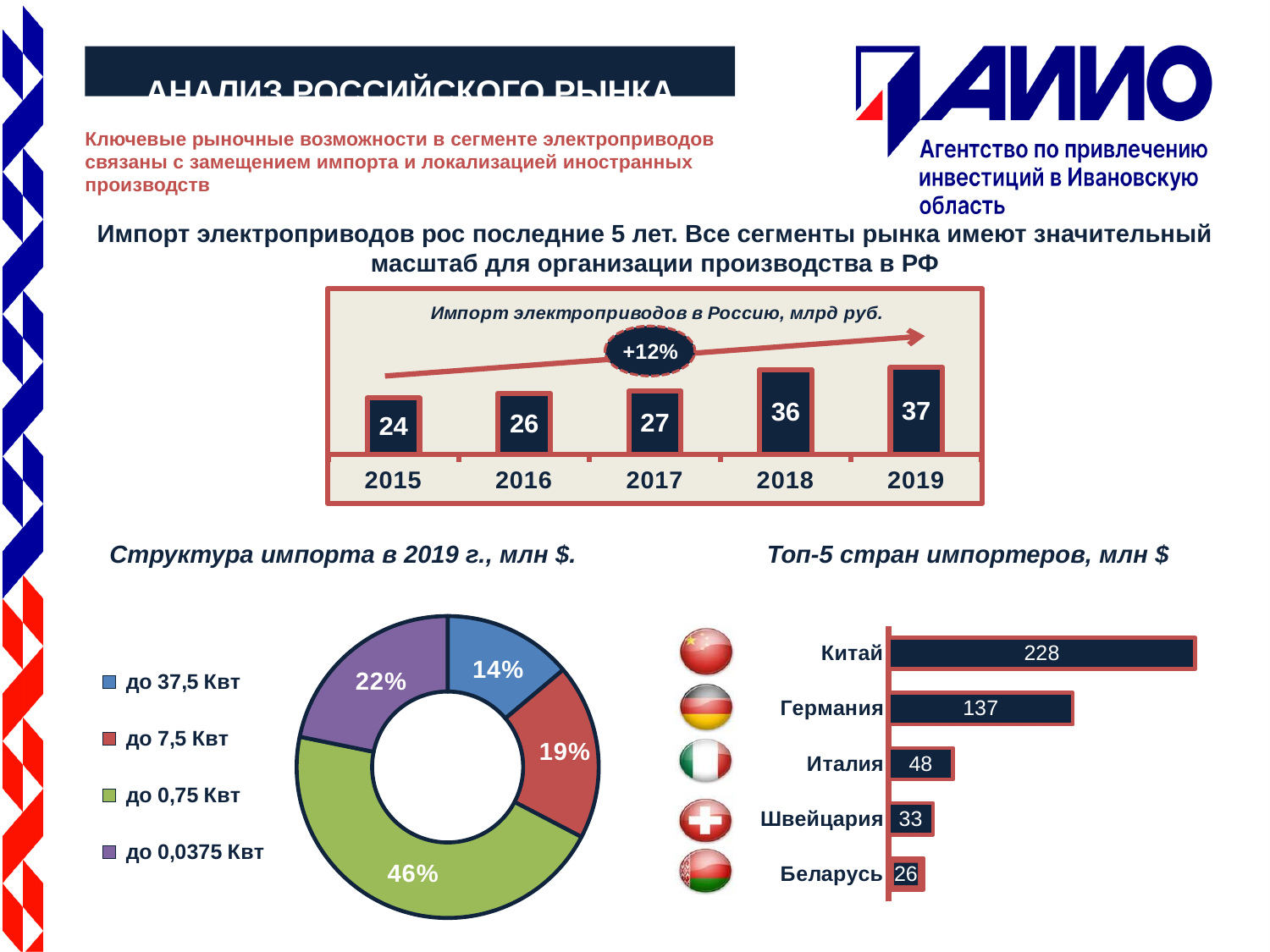
In the chart 'Структура импорта в 2019 г., млн $.', what share does 'до 0,75 Квт' have? 46% In the chart 'Топ-5 стран импортеров, млн $', what is the value for Германия? 137 In the chart 'Структура импорта в 2019 г., млн $.', which category has the smallest share? до 37,5 Квт In the chart 'Топ-5 стран импортеров, млн $', what is the difference between Китай and Италия? 180 In the chart 'Структура импорта в 2019 г., млн $.', what share does 'до 0,0375 Квт' have? 22% In the chart 'Импорт электроприводов в Россию, млрд руб.', what is the value for 2018? 36 In the chart 'Топ-5 стран импортеров, млн $', which is larger, Швейцария or Беларусь? Швейцария In the chart 'Импорт электроприводов в Россию, млрд руб.', what is the difference between the 2019 and 2015 values? 13 What kind of chart is 'Структура импорта в 2019 г., млн $.'? doughnut chart In the chart 'Импорт электроприводов в Россию, млрд руб.', how many years are shown? 5 In the chart 'Импорт электроприводов в Россию, млрд руб.', do the values rise or fall from 2015 to 2019? rise In the chart 'Импорт электроприводов в Россию, млрд руб.', which year has the lowest value? 2015